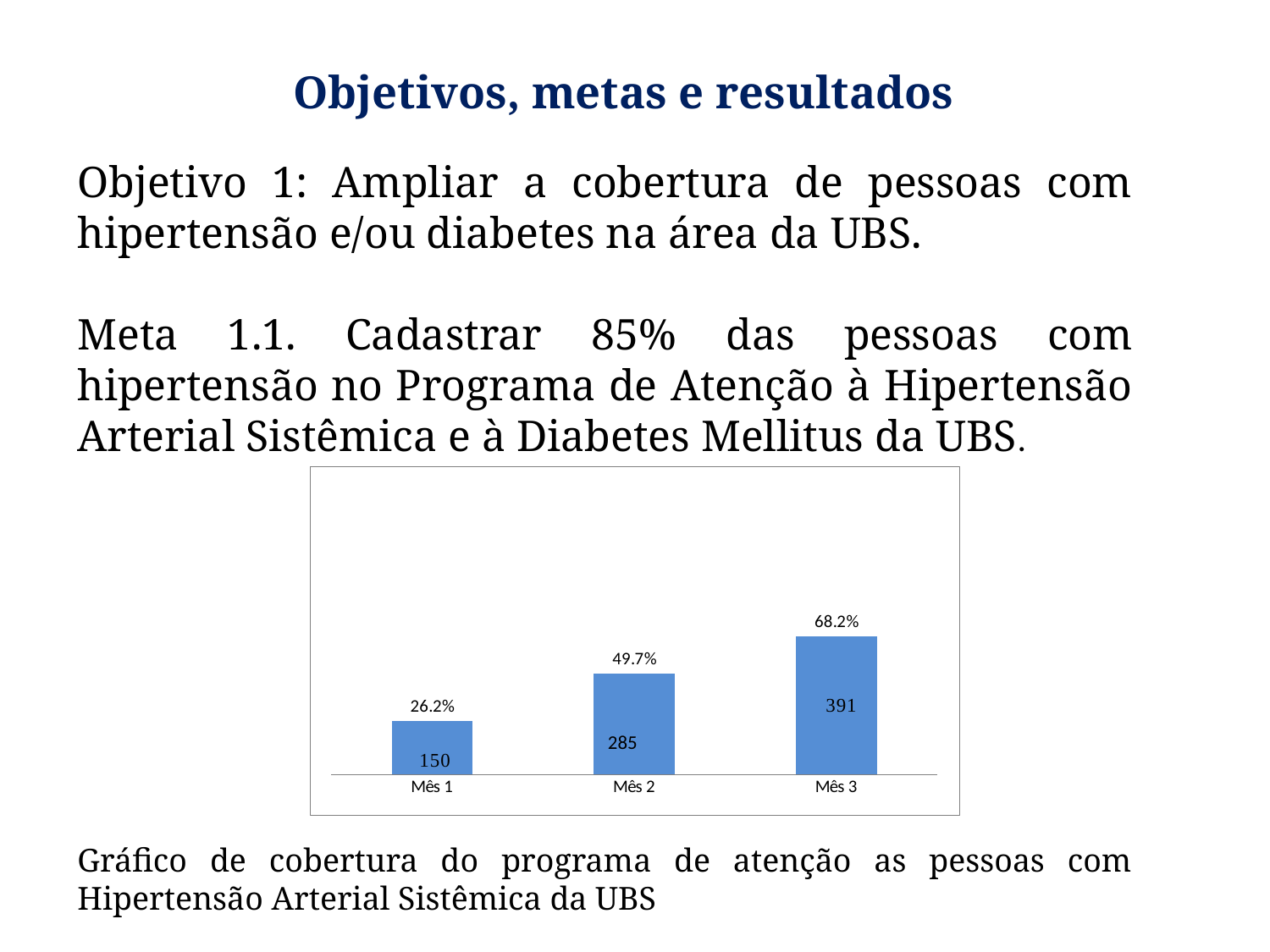
Which month has the highest bar? Mês 3 What percentage is shown above the bar for Mês 1? 26.2% Do the values rise or fall from Mês 1 to Mês 3? Rise How many bars are plotted in the chart? 3 Which is larger, the percentage for Mês 2 or the percentage for Mês 1? Mês 2 What kind of chart is shown on the slide? Bar chart What number is printed inside the bar for Mês 1? 150 What percentage is shown above the bar for Mês 2? 49.7% Which month has the lowest bar? Mês 1 What percentage is shown above the bar for Mês 3? 68.2% What is the difference between the number inside the bar for Mês 3 and the number inside the bar for Mês 2? 106 What number is printed inside the bar for Mês 3? 391